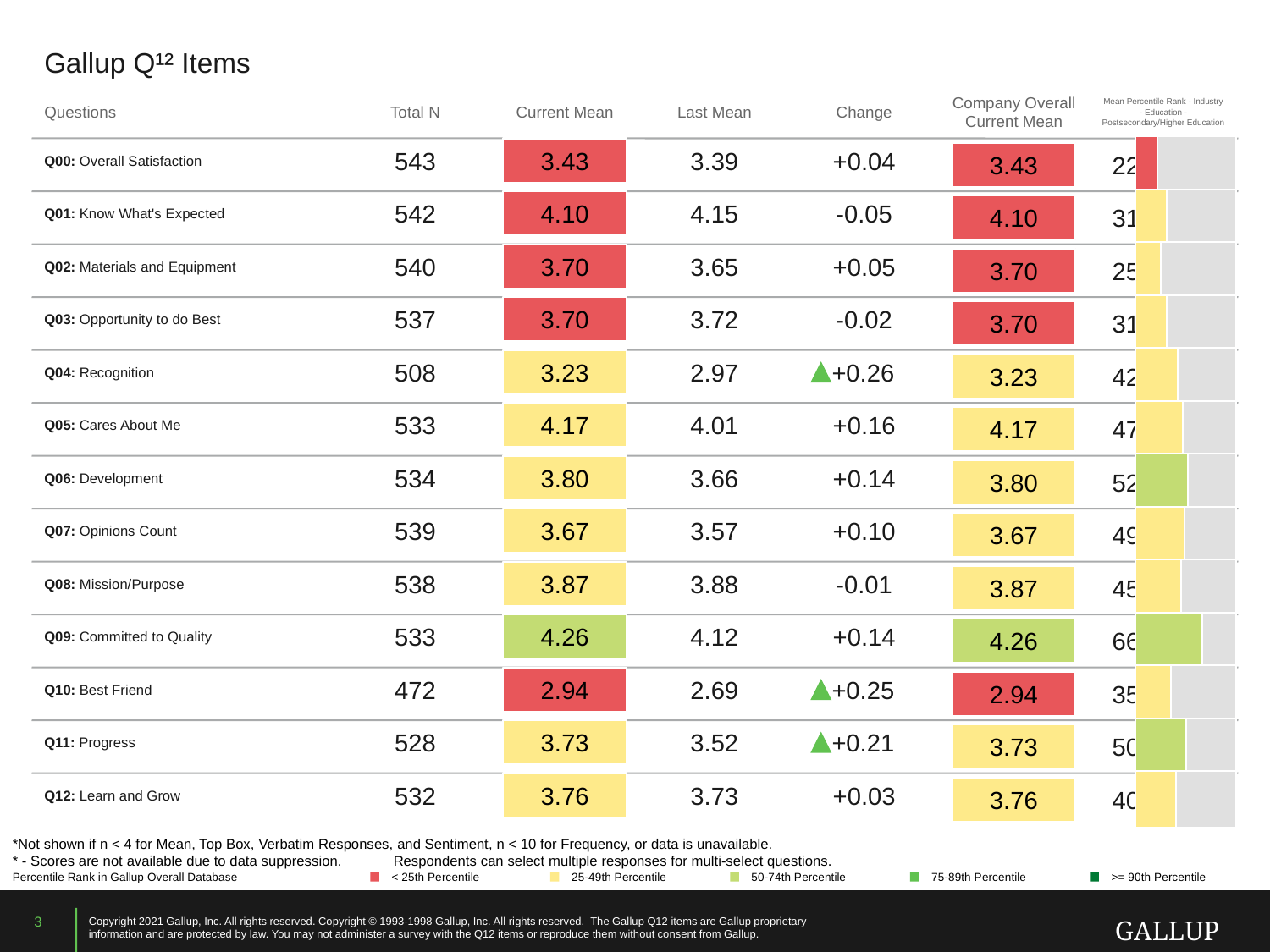
In the Mean Percentile Rank bar chart, what is the percentile rank for Q09: Committed to Quality? 66 What is the Total N for Q10: Best Friend? 472 What is the Current Mean for Q05: Cares About Me? 4.17 Is the Mean Percentile Rank for Q12: Learn and Grow greater or less than 50? less What kind of chart is used in the Mean Percentile Rank column? Bar chart How many items are shown in the Mean Percentile Rank bar chart? 13 In the Mean Percentile Rank bar chart, which has the higher percentile rank, Q04: Recognition or Q10: Best Friend? Q04: Recognition In the Mean Percentile Rank bar chart, which item has the lowest percentile rank? Q00: Overall Satisfaction In the Mean Percentile Rank bar chart, which item has the highest percentile rank? Q09: Committed to Quality What colour is the Current Mean cell for Q09: Committed to Quality? Green In the Mean Percentile Rank bar chart, what is the difference between the percentile rank for Q09: Committed to Quality and Q00: Overall Satisfaction? 44 What is the Change value for Q04: Recognition? +0.26